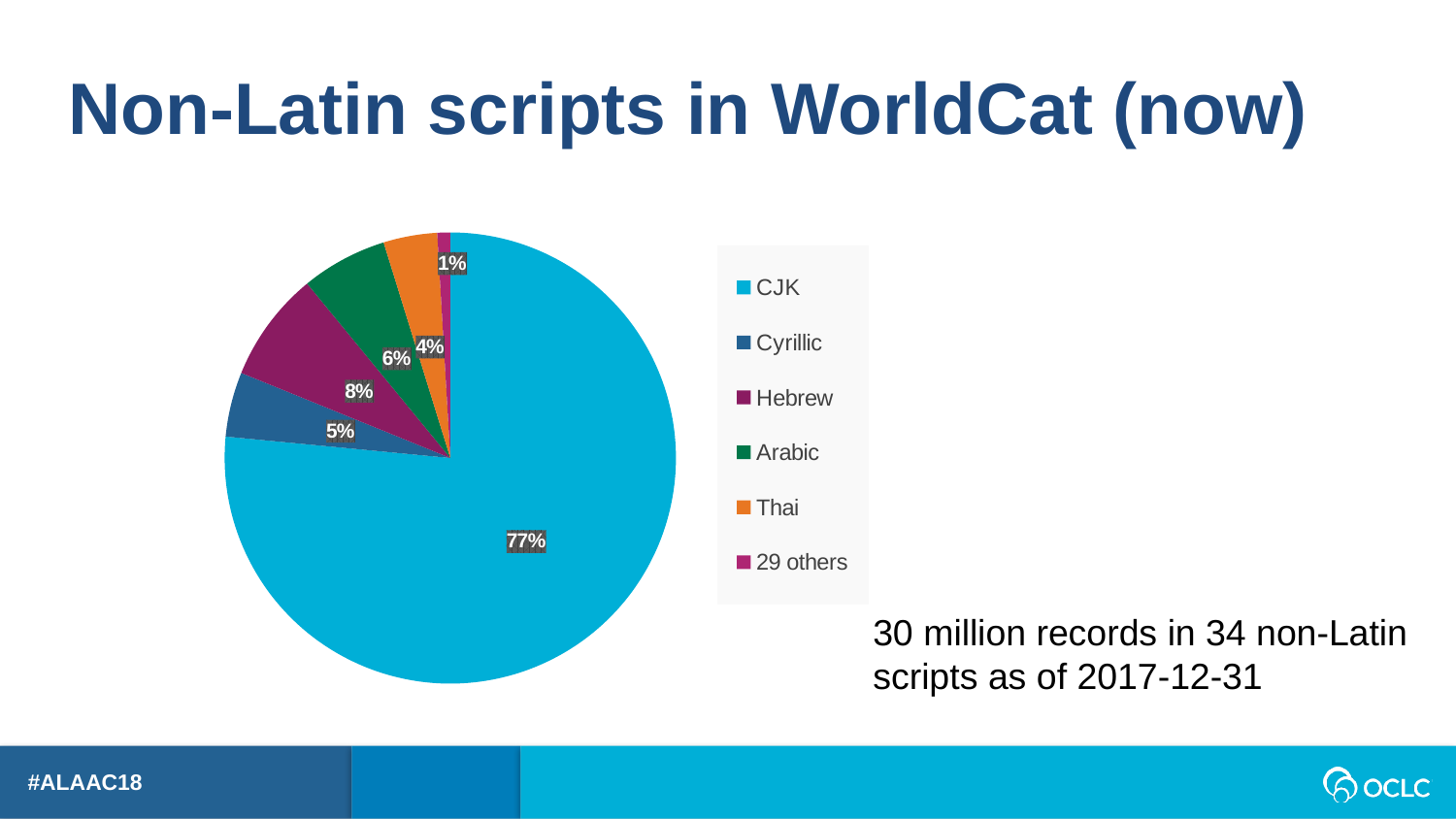
What kind of chart is shown on the slide? Pie chart What percentage is shown for Cyrillic? 5% Which has a larger share, Cyrillic or Arabic? Arabic What percentage is shown for Thai? 4% Which script has the largest slice of the pie? CJK What is the title of the slide containing the chart? Non-Latin scripts in WorldCat (now) How many entries does the legend list? 6 What percentage is shown for Hebrew? 8% What is the difference in percentage points between Hebrew and Arabic? 2 Which legend category has the smallest slice of the pie? 29 others What share of the pie does CJK account for? 77% How many slices does the pie chart have? 6